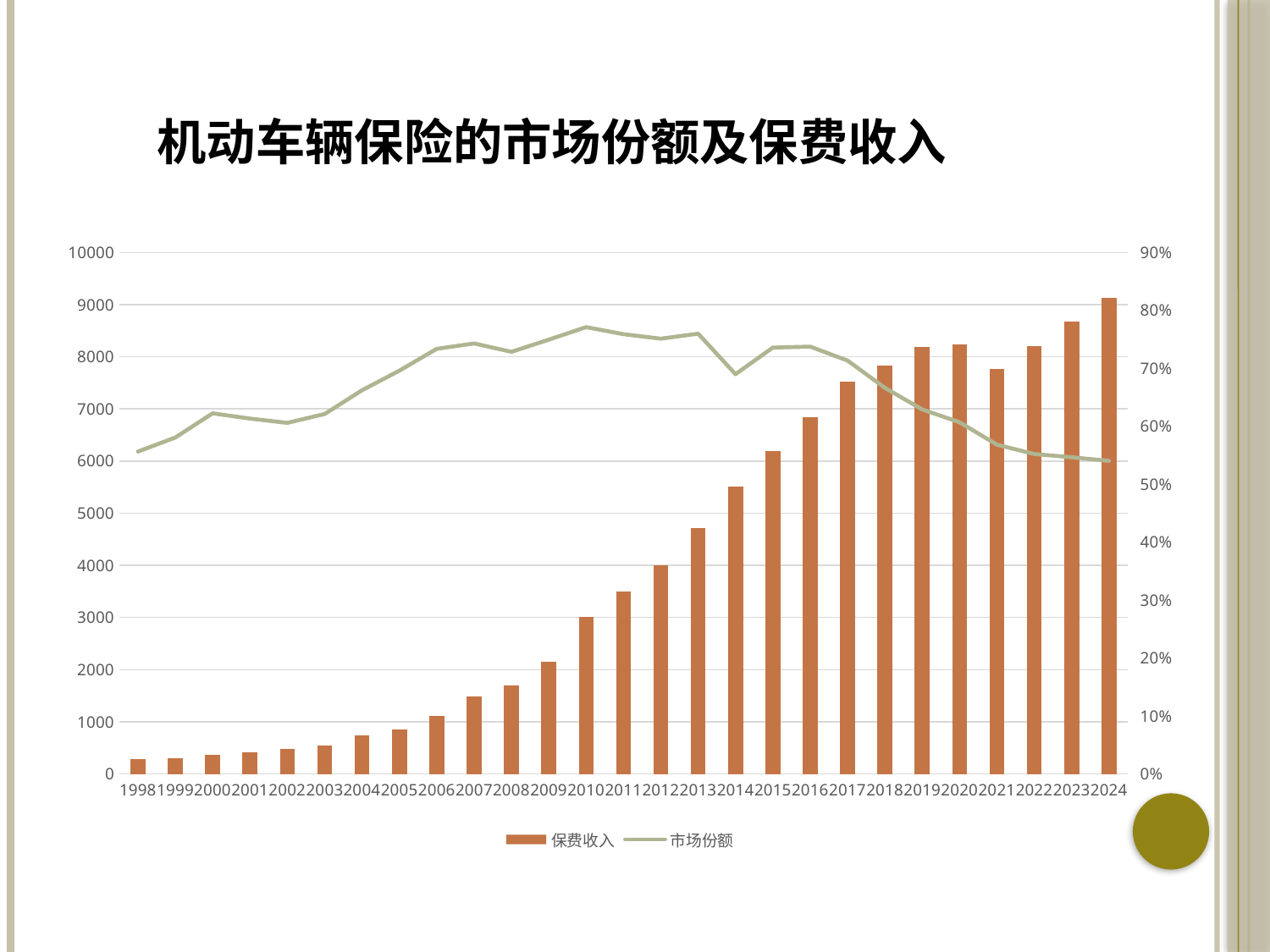
Is the 保费收入 value for 2005 greater or less than 1000? less Which year has the lowest 保费收入 bar? 1998 Is the 市场份额 value for 2021 greater or less than 60%? less How many years are shown on the x axis? 27 Does the 保费收入 series generally rise or fall from 1998 to 2024? rise Is the 保费收入 value for 2024 greater or less than 8000? greater Which is larger, the 保费收入 bar for 2021 or for 2023? 2023 What kind of chart is shown on the slide? Combined bar and line chart Which year has the highest 保费收入 bar? 2024 How many series does the legend list? 2